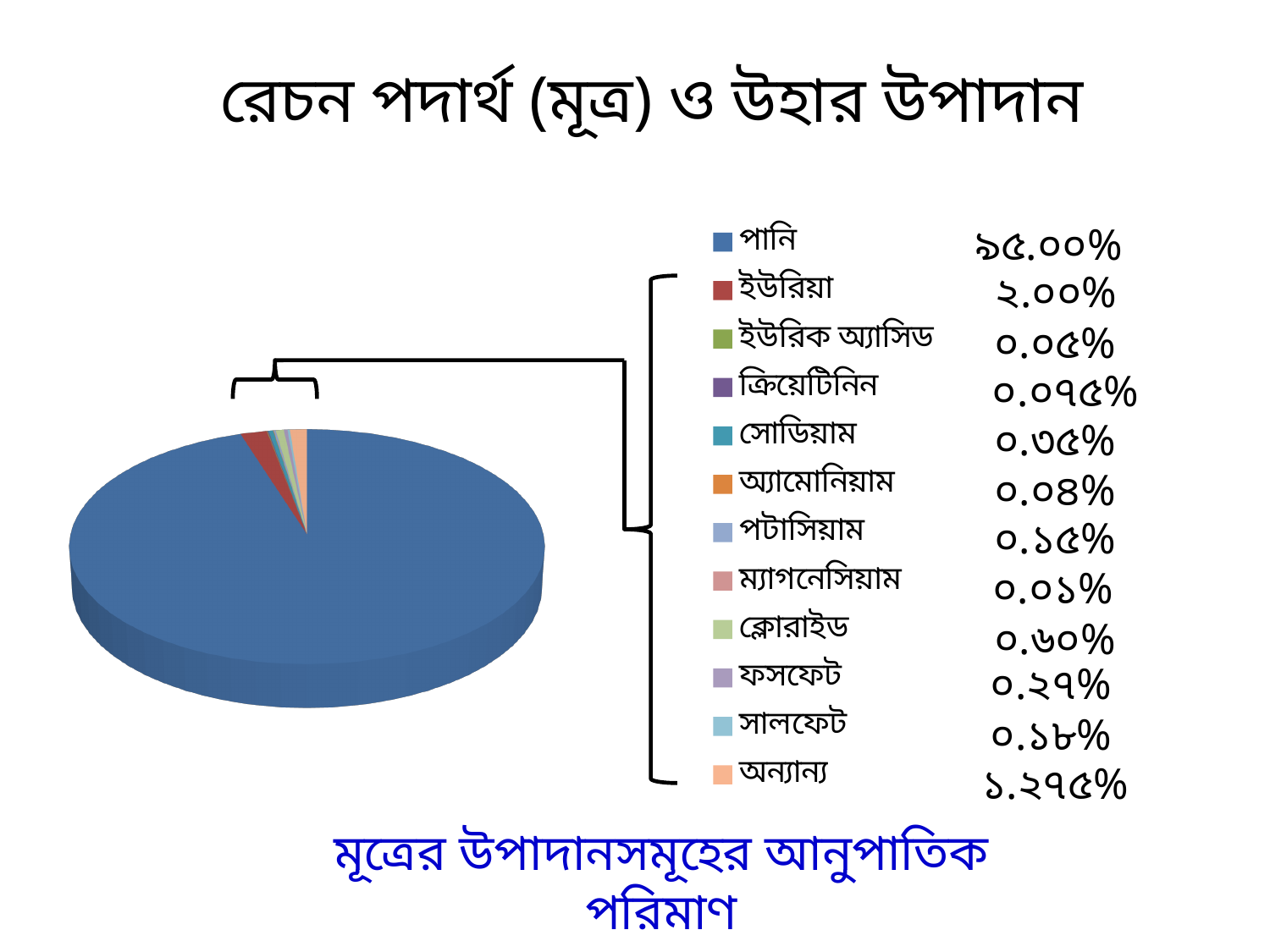
What is the value shown for ক্রিয়েটিনিন? ০.০৭৫% How many categories does the legend of the pie chart list? 12 What is the value shown for ক্লোরাইড? ০.৬০% What is the value shown for অন্যান্য? ১.২৭৫% What kind of chart is shown on the slide? pie chart What is the value shown for পানি? ৯৫.০০% What colour is the slice for পানি in the pie chart? blue What is the difference between the values for ফসফেট and সালফেট? ০.০৯% Which category has the smallest value listed? ম্যাগনেসিয়াম Which category has the largest share of the pie? পানি Which is larger, the value for সোডিয়াম or the value for পটাসিয়াম? সোডিয়াম What is the value shown for ইউরিয়া? ২.০০%